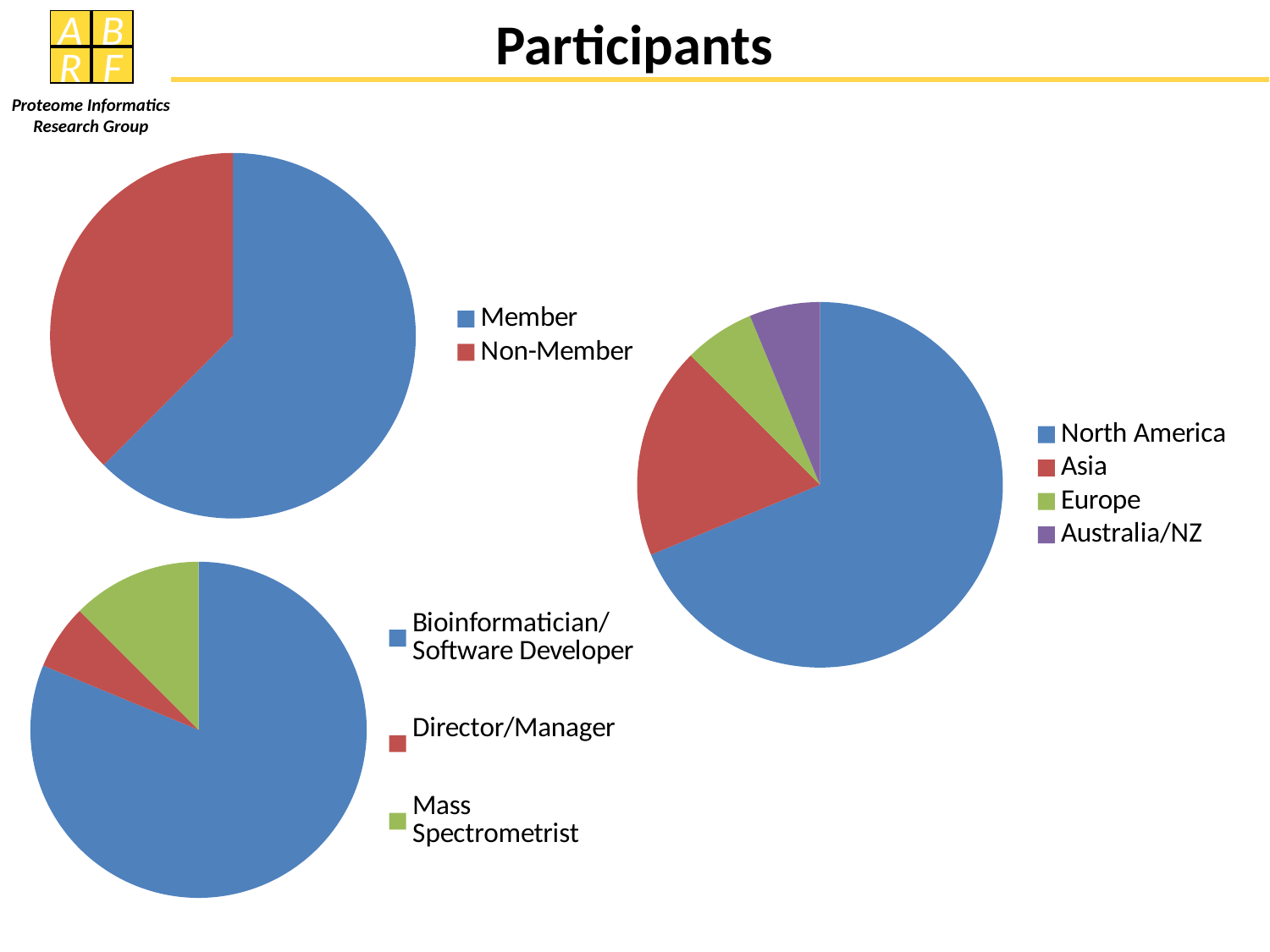
What colour is the Australia/NZ slice in the right-hand pie chart? Purple How many categories does the legend of the top-left pie chart list? 2 In the right-hand pie chart, which slice is larger, Asia or Europe? Asia In the top-left pie chart, which slice is larger, Member or Non-Member? Member In the bottom-left pie chart, which category has the smallest slice? Director/Manager What is the title of the slide containing the three pie charts? Participants In the bottom-left pie chart, which slice is larger, Mass Spectrometrist or Director/Manager? Mass Spectrometrist How many categories does the legend of the right-hand pie chart list? 4 What kind of chart is the top-left chart with the Member and Non-Member legend? Pie chart In the bottom-left pie chart, which category has the largest slice? Bioinformatician/Software Developer In the right-hand pie chart, which region has the largest slice? North America How many pie charts are shown on the slide? 3